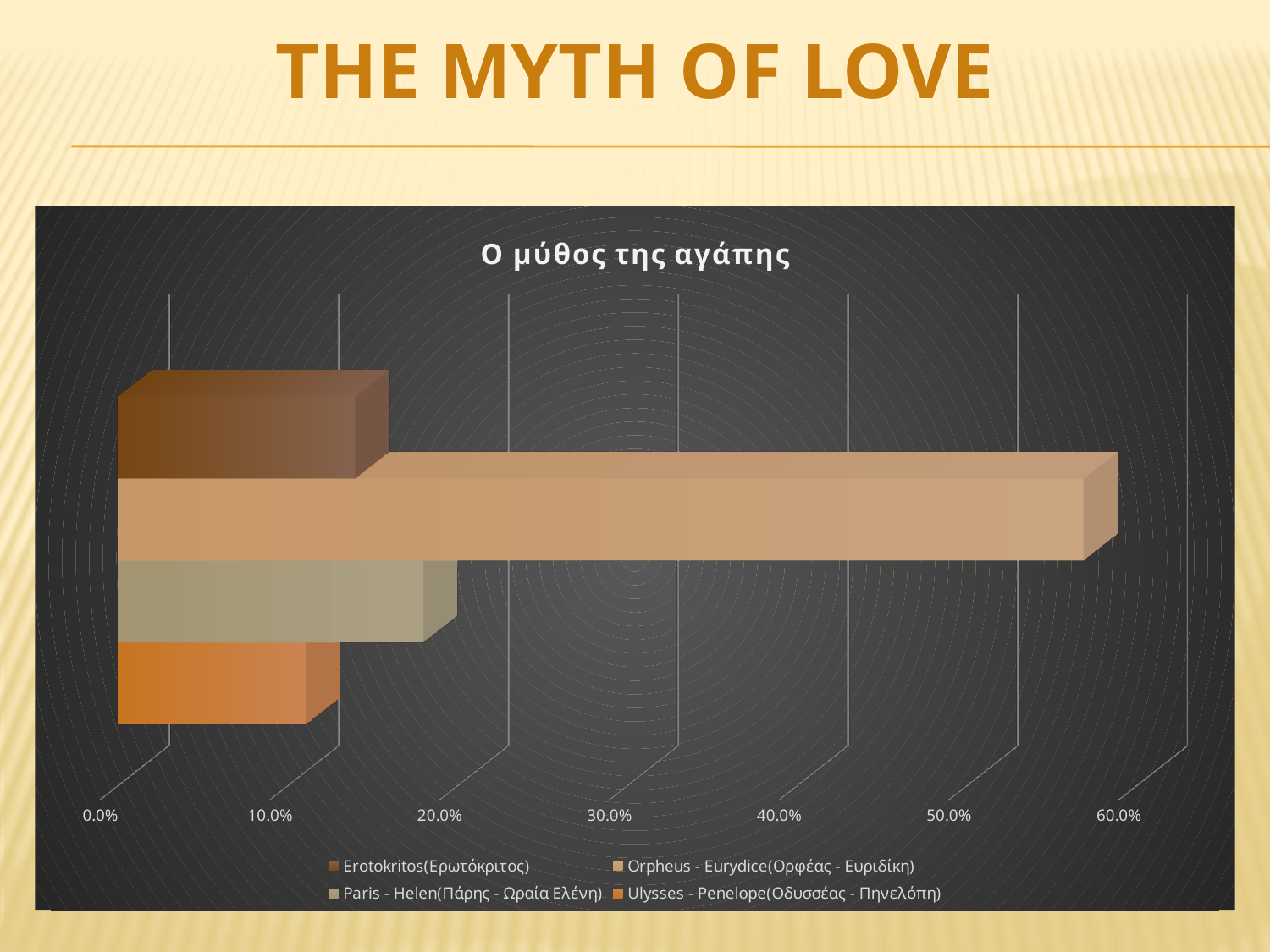
Which series has the lowest value? Ulysses - Penelope(Οδυσσέας - Πηνελόπη) What is the title of the chart? Ο μύθος της αγάπης Which series has the highest value? Orpheus - Eurydice(Ορφέας - Ευριδίκη) How many bars are plotted in the chart? 4 What kind of chart is shown on the slide? bar chart Which is larger, the value for Paris - Helen or the value for Ulysses - Penelope? Paris - Helen(Πάρης - Ωραία Ελένη) Is the value for Erotokritos greater or less than 20.0%? less Is the value for Ulysses - Penelope greater or less than 20.0%? less Which is larger, the value for Orpheus - Eurydice or the value for Paris - Helen? Orpheus - Eurydice(Ορφέας - Ευριδίκη) Is the value for Orpheus - Eurydice greater or less than 50.0%? greater How many series does the chart legend list? 4